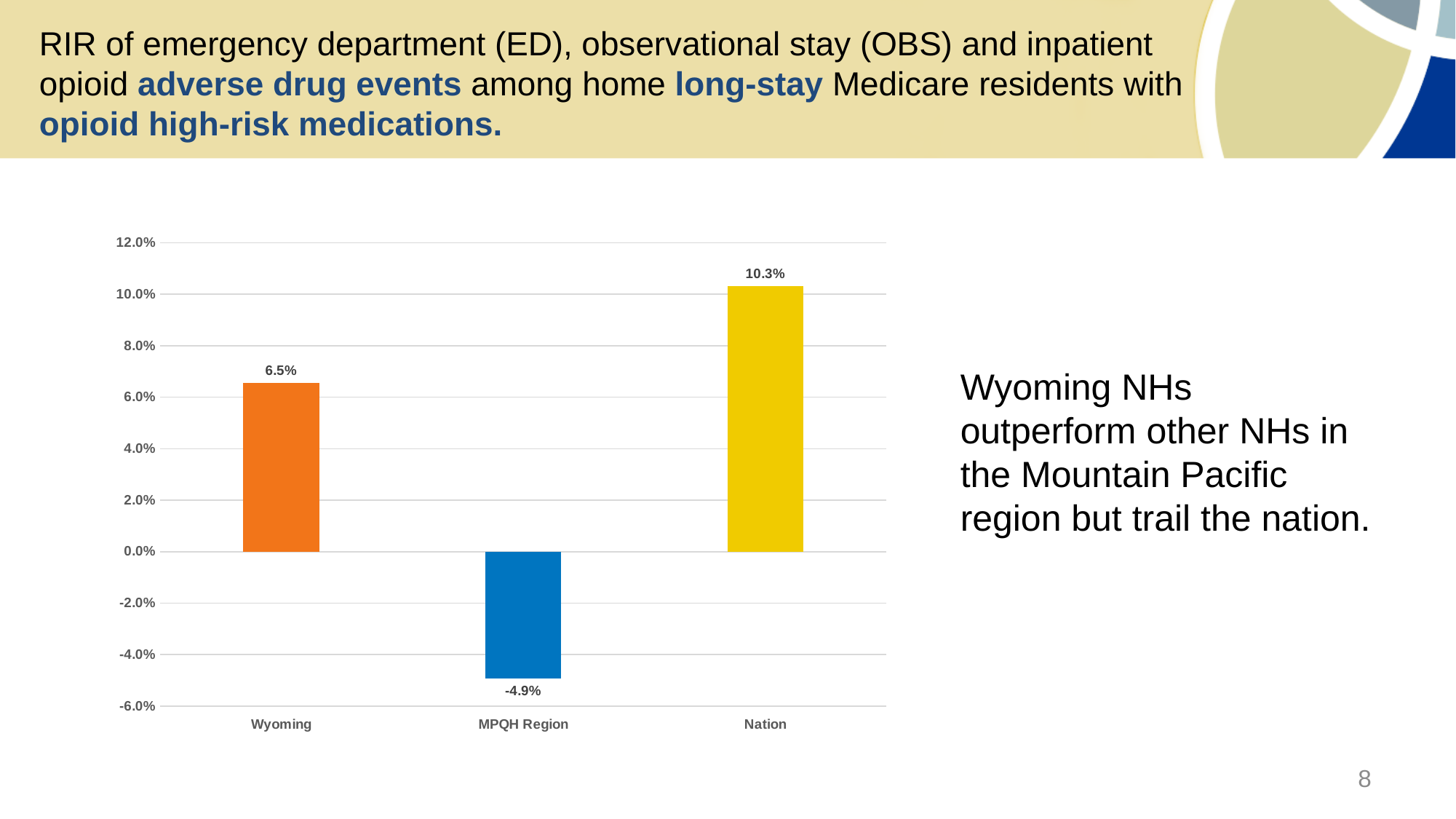
Which is larger, the value for Wyoming or the value for Nation? Nation What is the value for MPQH Region? -4.9% What is the difference between the values for Nation and Wyoming? 3.8% Is the value for Nation greater or less than 8.0%? greater Which category has the highest value? Nation How many categories are shown on the x axis? 3 What is the value for Wyoming? 6.5% What colour is the bar for MPQH Region? blue What is the difference between the values for Wyoming and MPQH Region? 11.4% What is the value for Nation? 10.3% Which category has the lowest value? MPQH Region What kind of chart is shown on the slide? bar chart